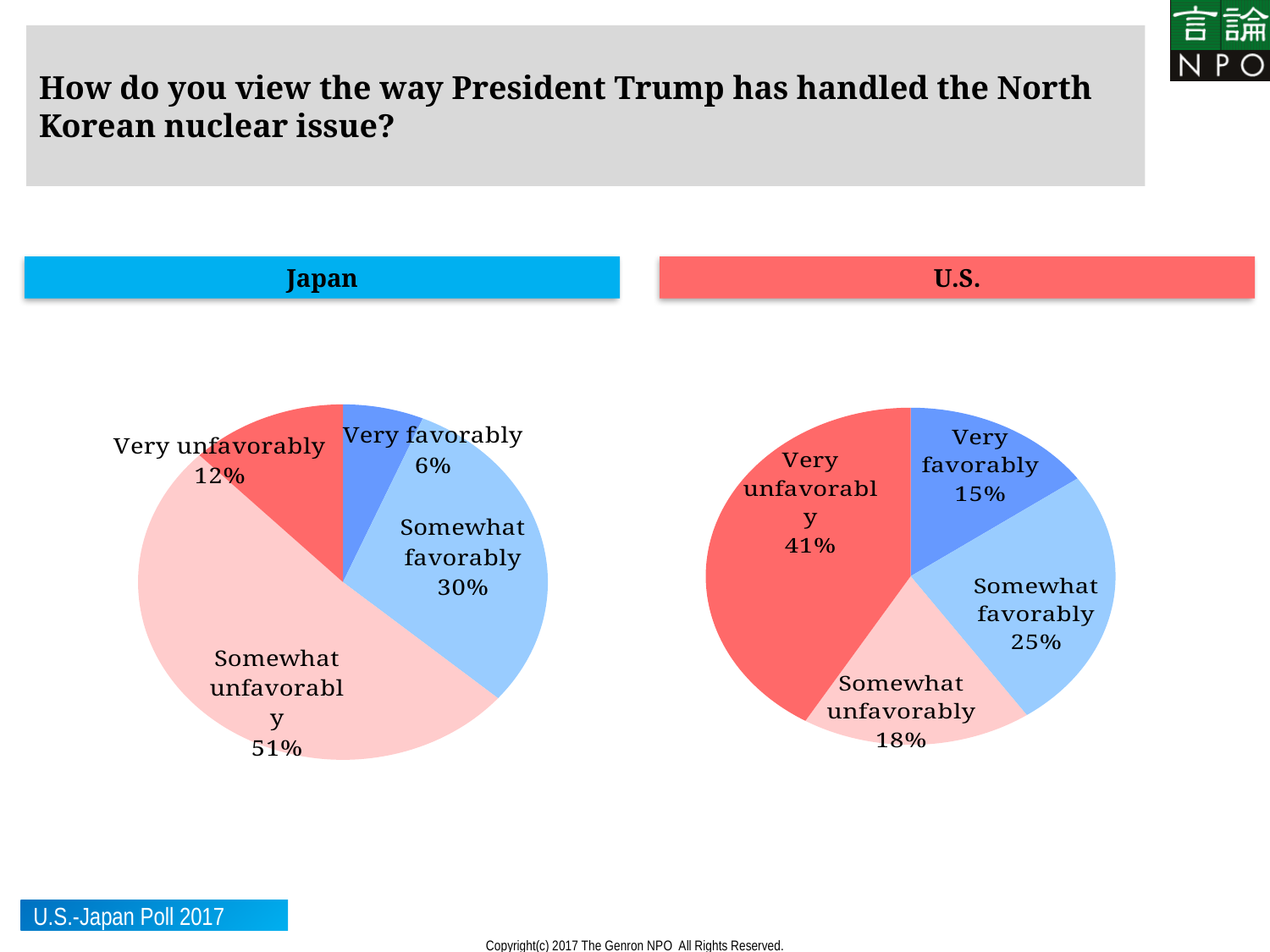
In the U.S. pie chart, what share of respondents answered "Very unfavorably"? 41% In the U.S. pie chart, which response has the smallest share? Very favorably In the Japan pie chart, what share of respondents answered "Very favorably"? 6% Which is larger: "Somewhat favorably" in the Japan chart or "Somewhat favorably" in the U.S. chart? Japan (30%) What is the difference between the "Very unfavorably" shares in the U.S. chart and the Japan chart? 29 percentage points In the U.S. pie chart, what is the combined share of "Very favorably" and "Somewhat favorably"? 40% In the Japan pie chart, which response has the largest share? Somewhat unfavorably What type of chart is used for the Japan data? Pie chart How many slices does the U.S. pie chart have? 4 In the Japan pie chart, which response has the smallest share? Very favorably In the Japan pie chart, what share of respondents answered "Somewhat unfavorably"? 51% In the U.S. pie chart, what share of respondents answered "Somewhat favorably"? 25%